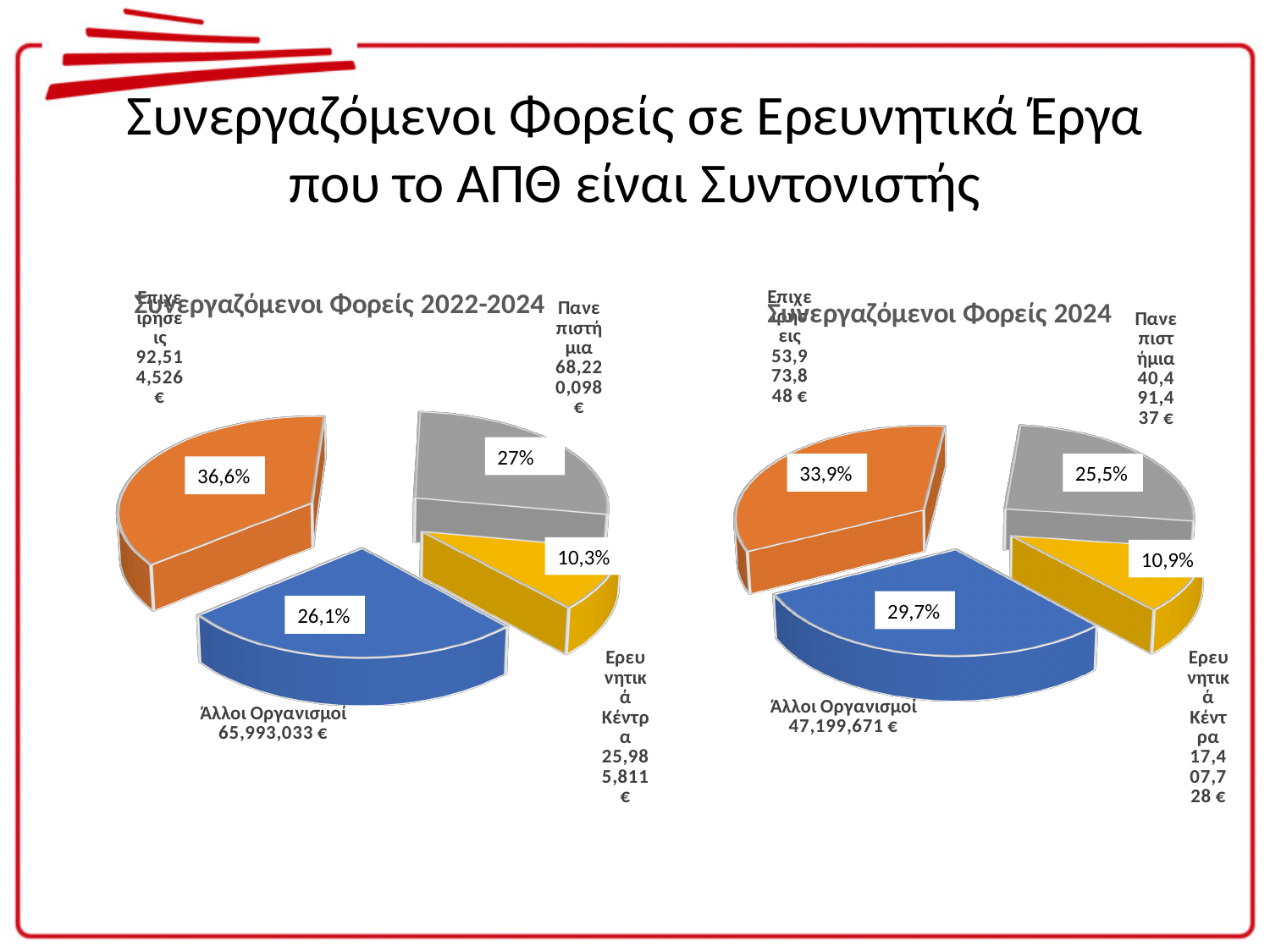
In the left chart (Συνεργαζόμενοι Φορείς 2022-2024), what percentage share is shown for Επιχειρήσεις? 36,6% In the right chart (Συνεργαζόμενοι Φορείς 2024), what value is shown for Άλλοι Οργανισμοί? 47,199,671 € In the left chart (Συνεργαζόμενοι Φορείς 2022-2024), which category has the largest share? Επιχειρήσεις In the right chart (Συνεργαζόμενοι Φορείς 2024), what percentage share is shown for Άλλοι Οργανισμοί? 29,7% What kind of chart is the right chart (Συνεργαζόμενοι Φορείς 2024)? Pie chart In the right chart (Συνεργαζόμενοι Φορείς 2024), which category has the largest share? Επιχειρήσεις In the right chart (Συνεργαζόμενοι Φορείς 2024), which is larger: the share for Πανεπιστήμια or the share for Άλλοι Οργανισμοί? Άλλοι Οργανισμοί In the left chart (Συνεργαζόμενοι Φορείς 2022-2024), what value is shown for Άλλοι Οργανισμοί? 65,993,033 € How many slices does the left chart (Συνεργαζόμενοι Φορείς 2022-2024) have? 4 In the left chart (Συνεργαζόμενοι Φορείς 2022-2024), what is the difference in percentage points between the share for Πανεπιστήμια and the share for Ερευνητικά Κέντρα? 16,7 percentage points In the right chart (Συνεργαζόμενοι Φορείς 2024), what percentage share is shown for Ερευνητικά Κέντρα? 10,9% In the left chart (Συνεργαζόμενοι Φορείς 2022-2024), which category has the smallest share? Ερευνητικά Κέντρα